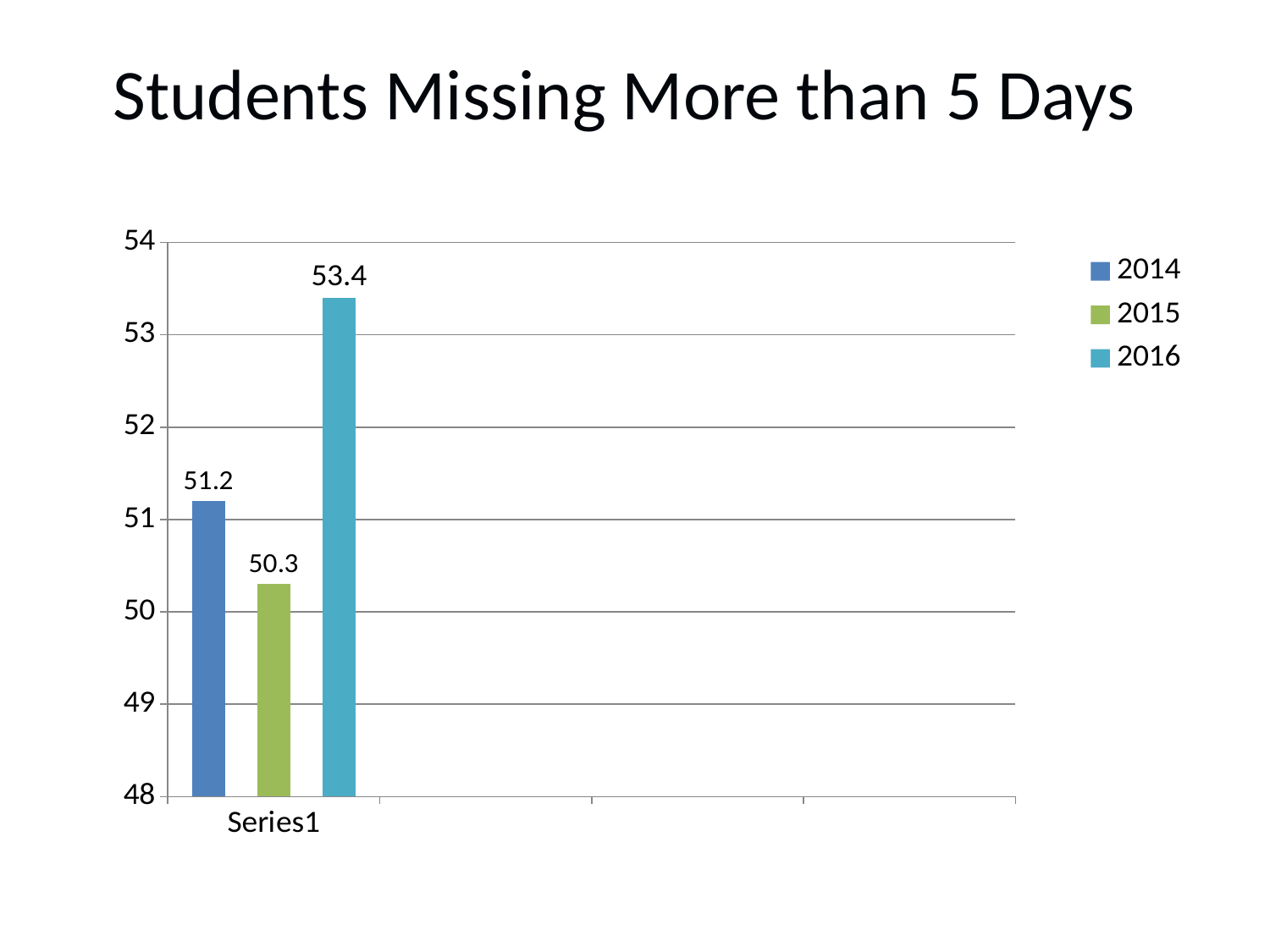
What is the title of the chart? Students Missing More than 5 Days What is the value for 2015? 50.3 What is the value for 2014? 51.2 Which year has the highest value? 2016 What is the value for 2016? 53.4 How many series does the legend list? 3 Is the value for 2016 greater or less than 53? greater What is the difference between the values for 2016 and 2014? 2.2 What is the difference between the values for 2014 and 2015? 0.9 Which is larger, the value for 2014 or the value for 2015? 2014 Which year has the lowest value? 2015 What kind of chart is shown on the slide? bar chart